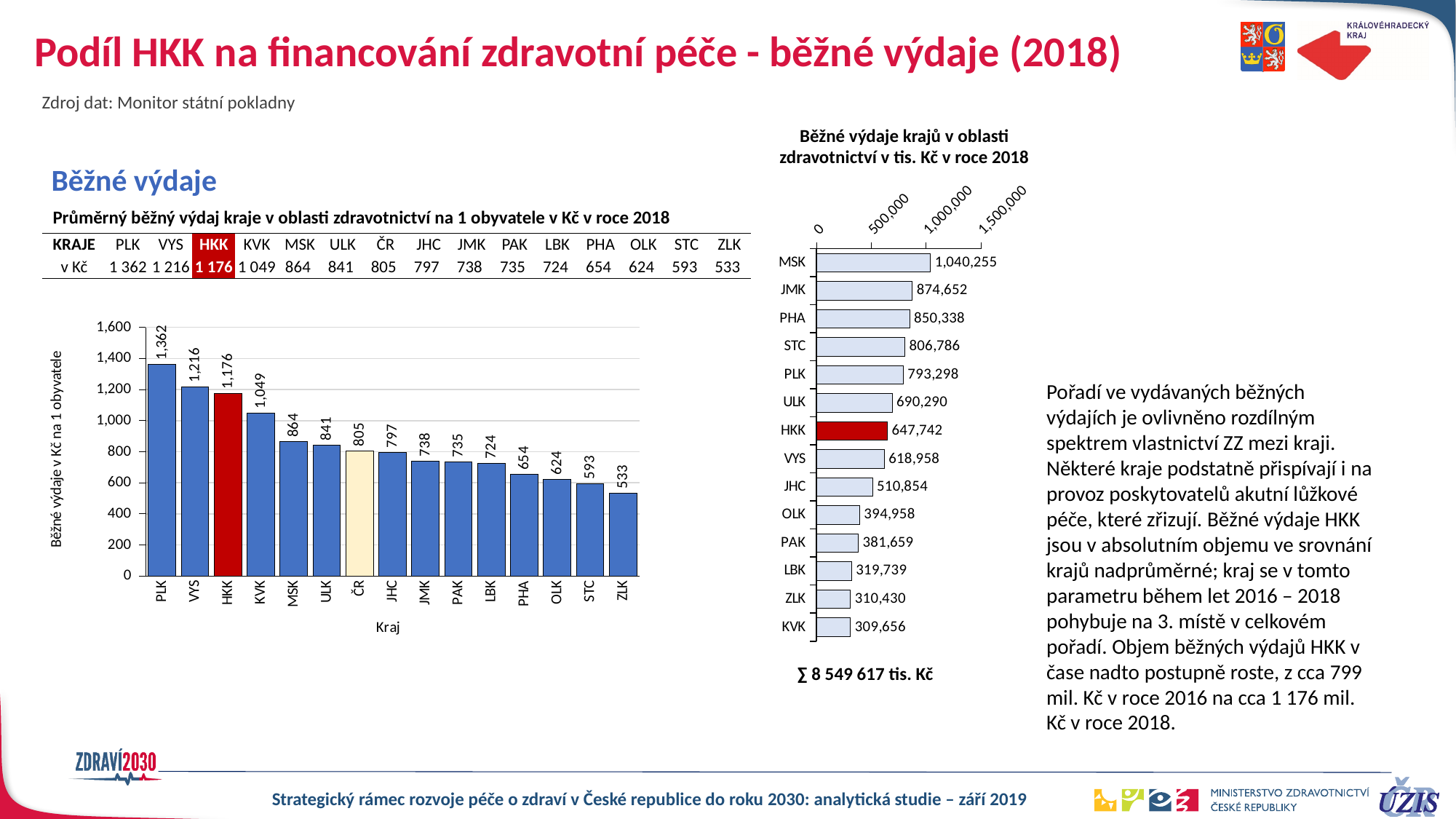
In the right chart (Běžné výdaje krajů v oblasti zdravotnictví v tis. Kč v roce 2018), what is the value for HKK? 647,742 In the left bar chart (Běžné výdaje v Kč na 1 obyvatele), do the values rise or fall from left to right along the x axis? fall In the left bar chart (Běžné výdaje v Kč na 1 obyvatele), which region has the highest value? PLK In the right chart (Běžné výdaje krajů v oblasti zdravotnictví v tis. Kč v roce 2018), which region has the highest value? MSK In the left bar chart (Běžné výdaje v Kč na 1 obyvatele), how many bars are plotted? 15 In the right chart (Běžné výdaje krajů v oblasti zdravotnictví v tis. Kč v roce 2018), which region has the lowest value? KVK In the left bar chart (Běžné výdaje v Kč na 1 obyvatele), what is the difference between PLK and HKK? 186 In the right chart (Běžné výdaje krajů v oblasti zdravotnictví v tis. Kč v roce 2018), how many regions are plotted? 14 In the left bar chart (Běžné výdaje v Kč na 1 obyvatele), which region has the lowest value? ZLK In the left bar chart (Běžné výdaje v Kč na 1 obyvatele), what is the value for HKK? 1,176 In the right chart (Běžné výdaje krajů v oblasti zdravotnictví v tis. Kč v roce 2018), which is larger, the value for JMK or the value for PHA? JMK What type of chart is the right chart (Běžné výdaje krajů v oblasti zdravotnictví v tis. Kč v roce 2018)? bar chart